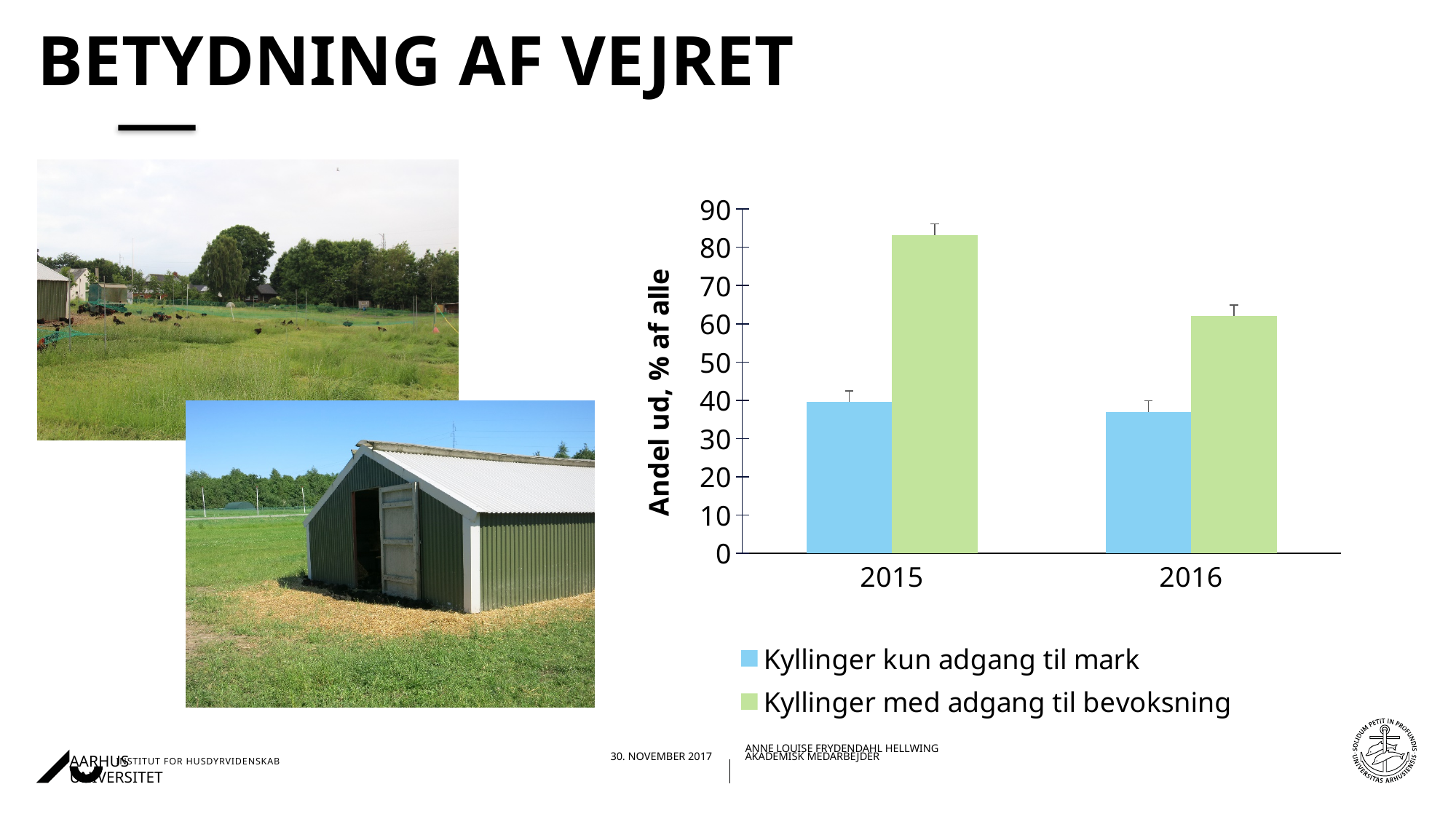
Is the value for 'Kyllinger med adgang til bevoksning' in 2016 greater or less than 50? greater How many categories are shown on the x axis of the chart? 2 In 2015, which series has the larger value: 'Kyllinger kun adgang til mark' or 'Kyllinger med adgang til bevoksning'? Kyllinger med adgang til bevoksning How many series does the chart's legend list? 2 What is the label on the y axis of the chart? Andel ud, % af alle What kind of chart is shown on the slide? bar chart Is the value for 'Kyllinger med adgang til bevoksning' in 2015 greater or less than 70? greater Does the value for 'Kyllinger med adgang til bevoksning' rise or fall from 2015 to 2016? fall Which year has the highest bar for 'Kyllinger med adgang til bevoksning'? 2015 Which bar is the tallest in the whole chart? Kyllinger med adgang til bevoksning in 2015 Which series is shown in blue in the chart? Kyllinger kun adgang til mark Is the value for 'Kyllinger kun adgang til mark' in 2016 greater or less than 50? less